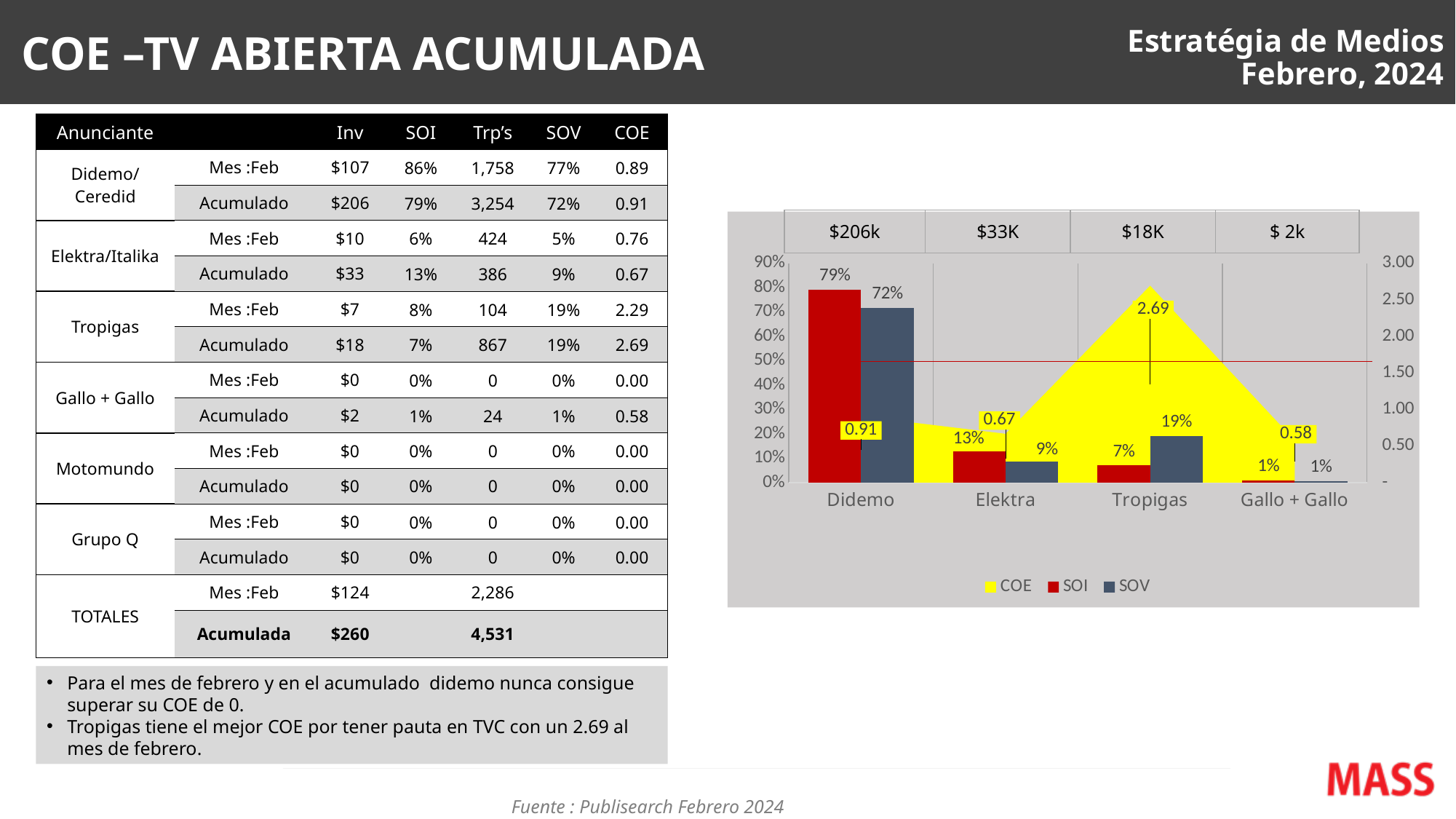
What investment amount is shown above the Elektra category in the chart? $33K What is the SOI value for Didemo in the chart? 79% What is the difference between the SOI and SOV values for Didemo? 7% What is the SOV value for Tropigas in the chart? 19% How many categories are shown on the x axis of the chart? 4 Does the SOI value fall or rise from Didemo to Gallo + Gallo along the x axis? fall Which category has the lowest SOI value in the chart? Gallo + Gallo What COE value is shown for Elektra in the chart? 0.67 Which series is shown in yellow in the chart? COE How many series does the chart legend list? 3 Which is larger for Tropigas, the SOI value or the SOV value? SOV Which category has the highest COE value in the chart? Tropigas